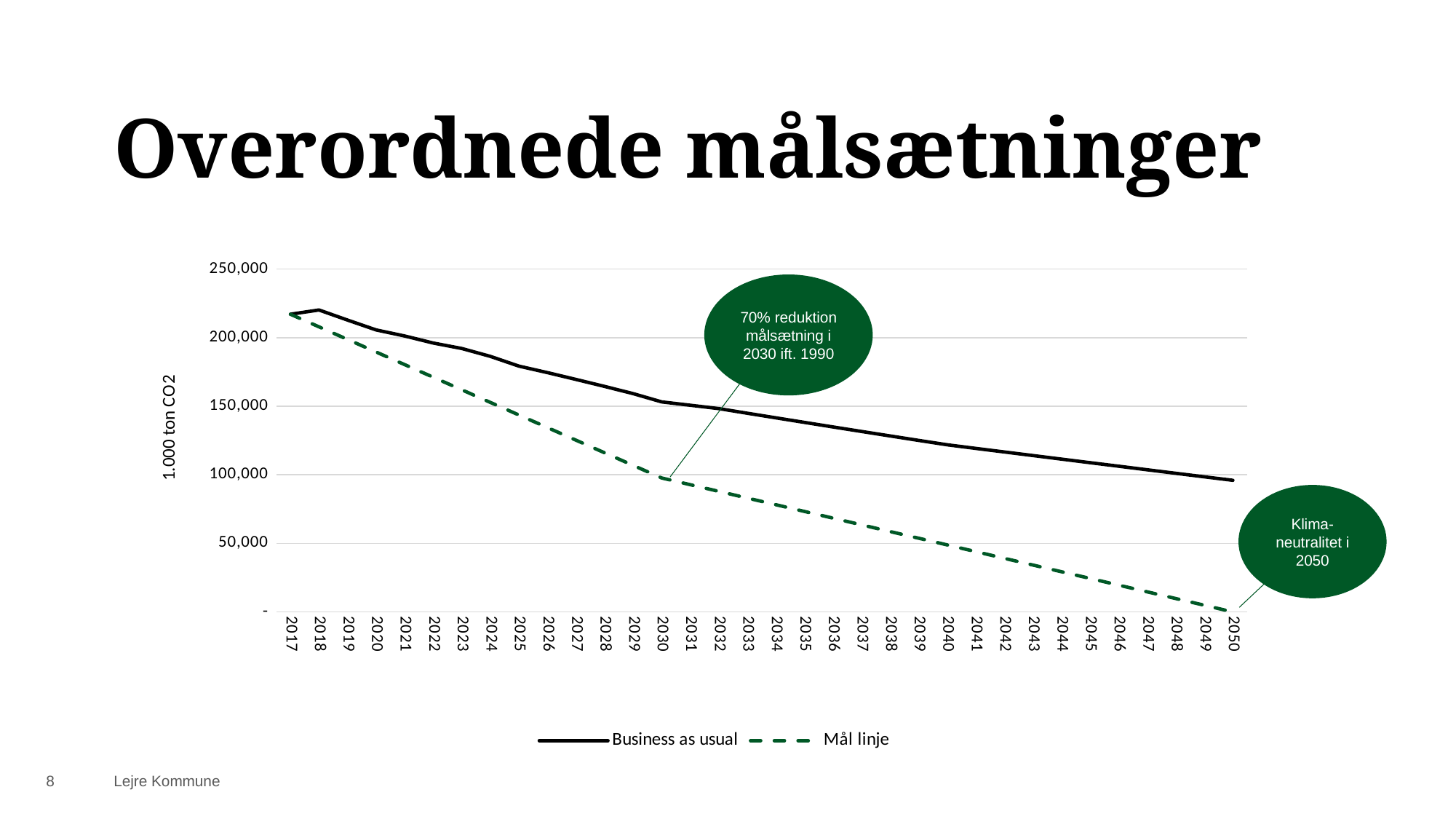
What kind of chart is shown on the slide? line chart Is the value for Mål linje in 2020 greater or less than 200,000? less Is the value for Mål linje in 2045 greater or less than 50,000? less How many years are shown on the x axis? 34 What are the two series named in the legend? Business as usual and Mål linje In which year does the Mål linje series reach its lowest value? 2050 In 2040, which series has the higher value, Business as usual or Mål linje? Business as usual What is the label of the y axis? 1.000 ton CO2 Do the values of the Mål linje series rise or fall from 2017 to 2050? fall How many series does the legend list? 2 Do the values of the Business as usual series rise or fall from 2020 to 2050? fall Is the value for Business as usual in 2040 greater or less than 100,000? greater